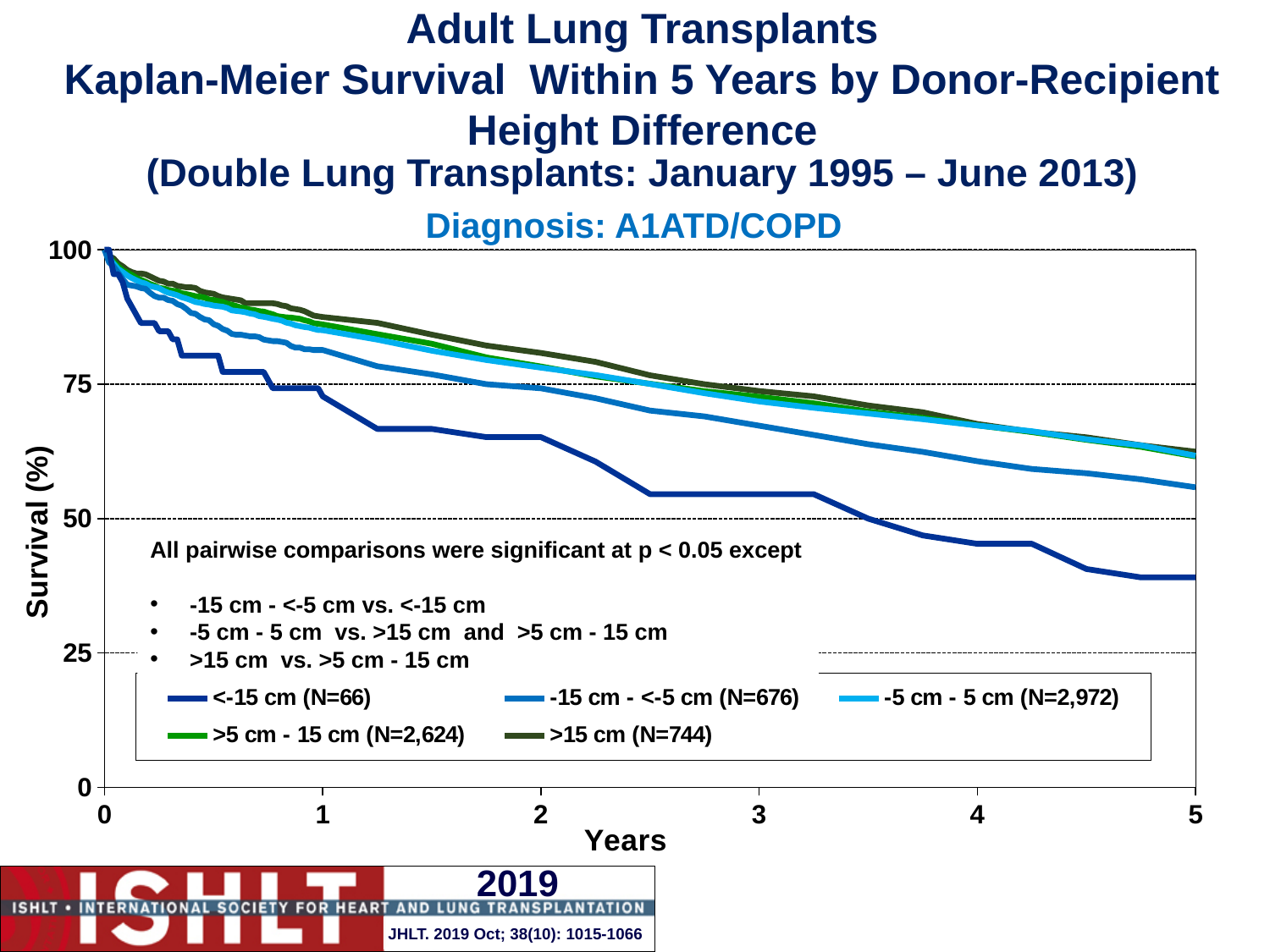
At 5 years, which has higher survival: the <-15 cm group or the -5 cm - 5 cm group? -5 cm - 5 cm Is the survival for the <-15 cm group at 5 years greater or less than 50? less How many series does the legend list? 5 Which diagnosis group does the chart cover? A1ATD/COPD Which height-difference group has the lowest survival at 5 years? <-15 cm Do the survival curves rise or fall as years increase? fall Is the survival for the >15 cm group at 5 years greater or less than 75? less What is the N shown in the legend for the <-15 cm group? 66 What kind of chart is shown on the slide? line chart Is the survival for the >15 cm group at 1 year greater or less than 75? greater